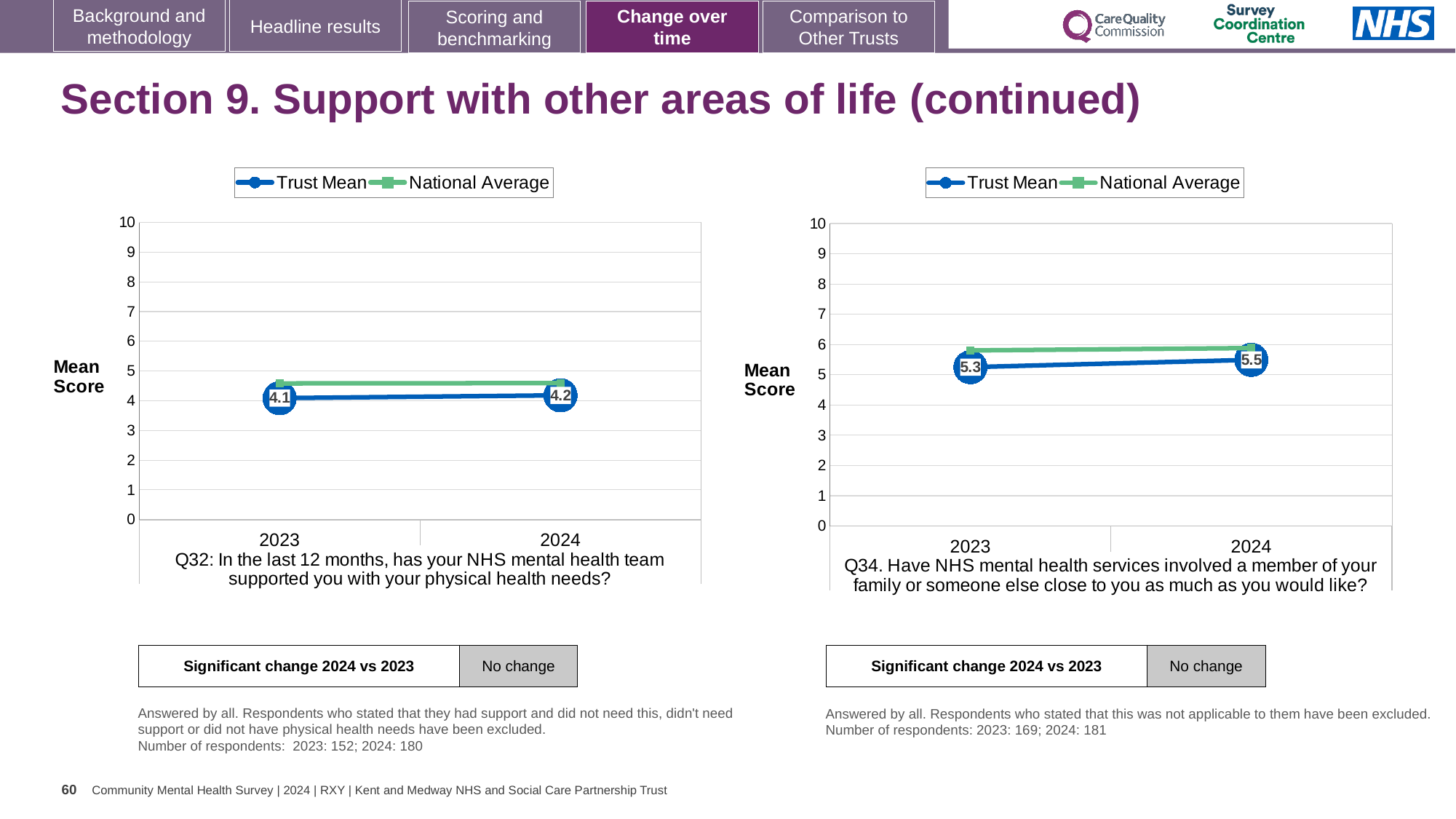
How many series does the legend of the left chart list? 2 In the right chart (Q34), is the National Average for 2024 greater or less than 7? less How many years are plotted on the x axis of the right chart? 2 In the right chart (Q34), what is the Trust Mean for 2024? 5.5 What kind of chart is used for Q34 on the right? line chart In the right chart (Q34), what is the Trust Mean for 2023? 5.3 In the left chart (Q32), what is the Trust Mean for 2024? 4.2 In the right chart (Q34), which is larger in 2023, the Trust Mean or the National Average? National Average In the left chart (Q32), does the Trust Mean rise or fall from 2023 to 2024? rise In the right chart (Q34), by how much did the Trust Mean change from 2023 to 2024? 0.2 In the left chart (Q32), what is the Trust Mean for 2023? 4.1 In the left chart (Q32), is the National Average for 2023 greater or less than 4? greater